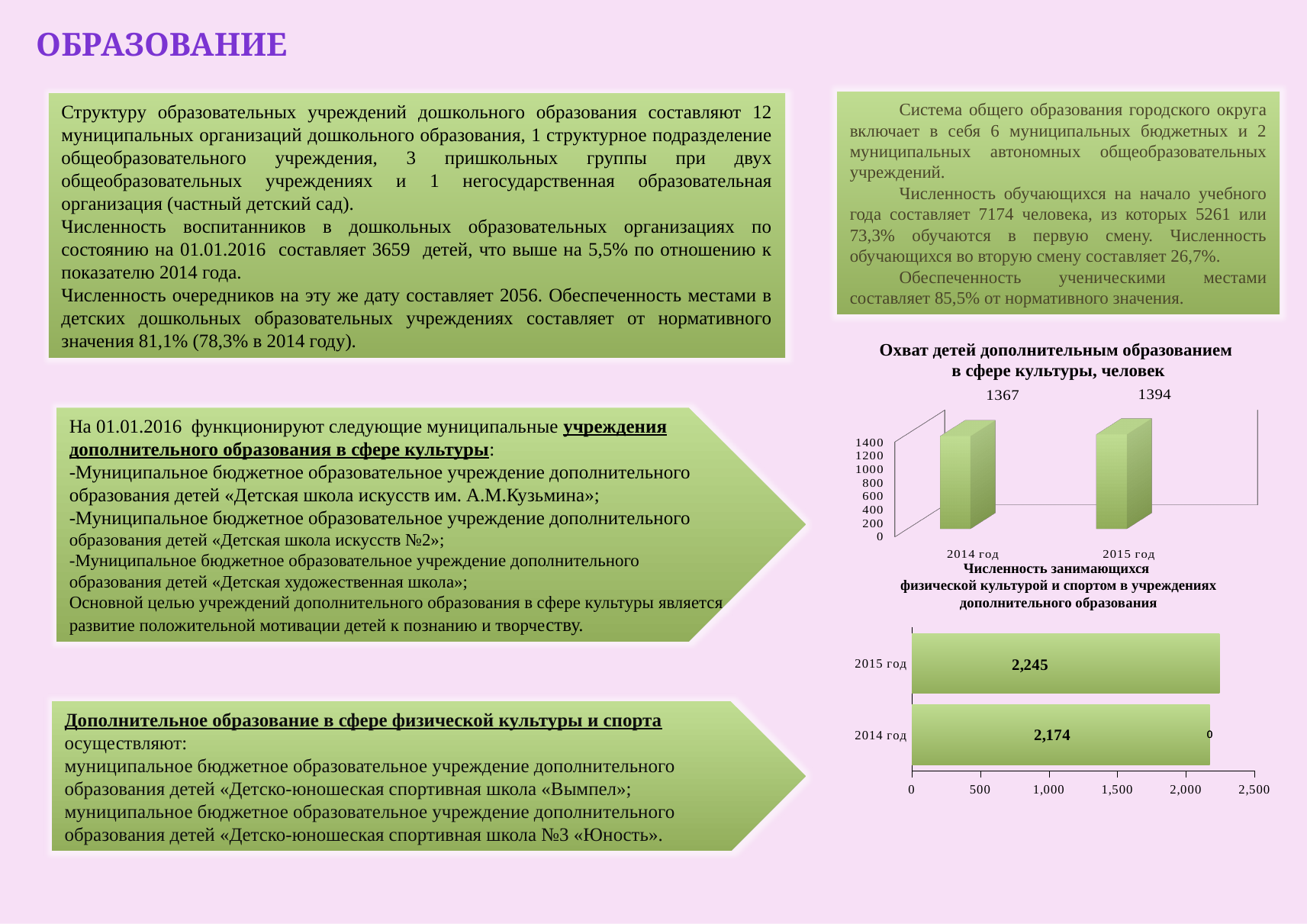
In the chart 'Охват детей дополнительным образованием в сфере культуры, человек', which year has the higher value? 2015 год In the chart 'Численность занимающихся физической культурой и спортом в учреждениях дополнительного образования', what is the value for 2015 год? 2,245 In the chart 'Охват детей дополнительным образованием в сфере культуры, человек', what is the value for 2014 год? 1367 In the chart 'Охват детей дополнительным образованием в сфере культуры, человек', what is the difference between the 2015 год and 2014 год values? 27 In the chart 'Численность занимающихся физической культурой и спортом в учреждениях дополнительного образования', what is the value for 2014 год? 2,174 What kind of chart is 'Численность занимающихся физической культурой и спортом в учреждениях дополнительного образования'? bar chart In the chart 'Охват детей дополнительным образованием в сфере культуры, человек', how many categories are shown? 2 In the chart 'Численность занимающихся физической культурой и спортом в учреждениях дополнительного образования', what is the difference between the 2015 год and 2014 год values? 71 In the chart 'Численность занимающихся физической культурой и спортом в учреждениях дополнительного образования', which year has the lower value? 2014 год In the chart 'Численность занимающихся физической культурой и спортом в учреждениях дополнительного образования', is the value for 2014 год greater or less than 2,000? greater In the chart 'Охват детей дополнительным образованием в сфере культуры, человек', do the values rise or fall from 2014 год to 2015 год? rise In the chart 'Охват детей дополнительным образованием в сфере культуры, человек', what is the value for 2015 год? 1394